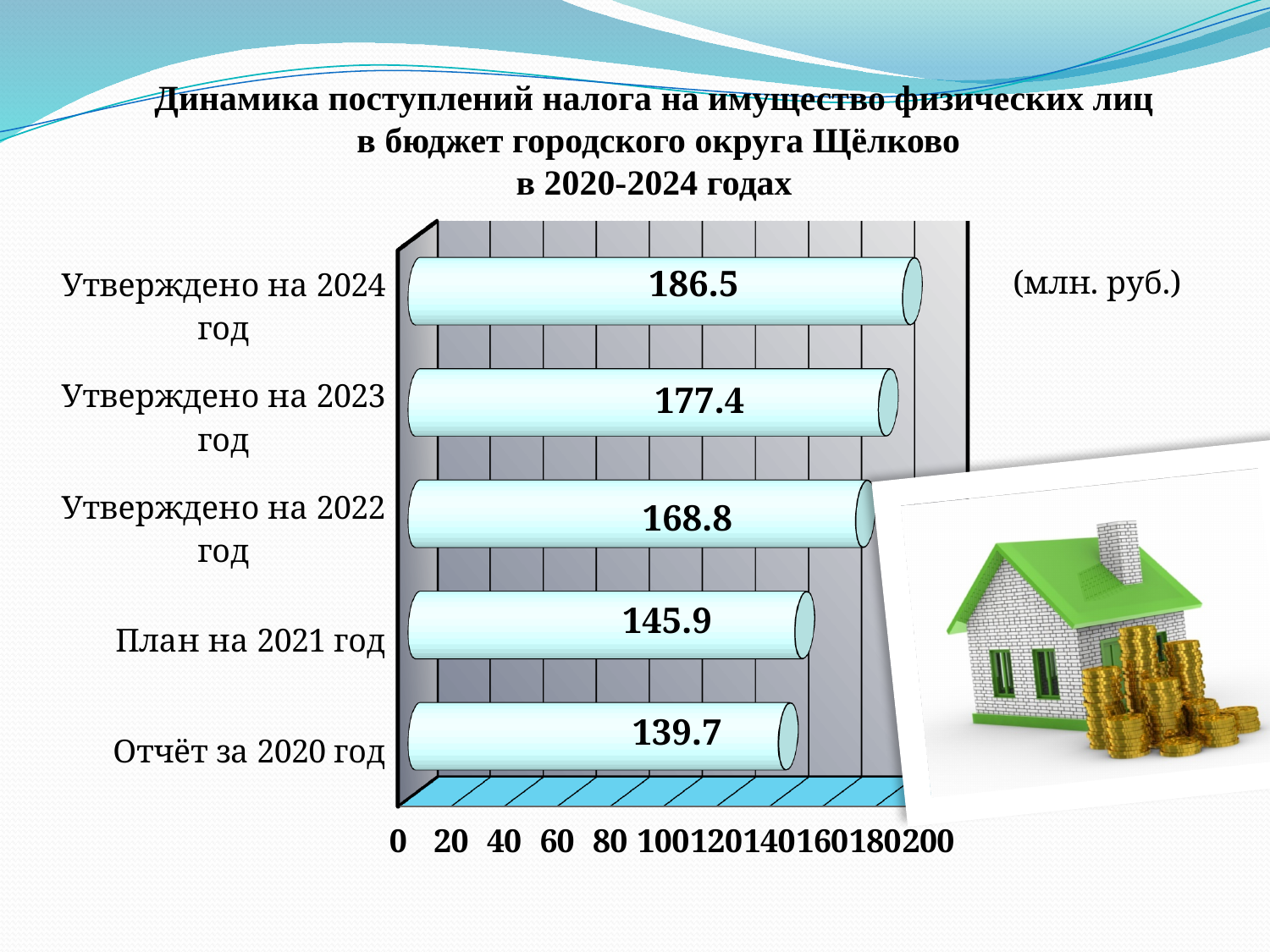
What is the difference between the values for "Утверждено на 2024 год" and "Утверждено на 2023 год"? 9.1 Do the values rise or fall from "Отчёт за 2020 год" to "Утверждено на 2024 год"? Rise What kind of chart is shown on the slide? Bar chart What is the difference between the values for "План на 2021 год" and "Отчёт за 2020 год"? 6.2 What value is shown for "Отчёт за 2020 год"? 139.7 What value is shown for "Утверждено на 2024 год"? 186.5 How many categories are shown in the chart? 5 Which category has the highest value? Утверждено на 2024 год What value is shown for "План на 2021 год"? 145.9 Which category has the lowest value? Отчёт за 2020 год What value is shown for "Утверждено на 2022 год"? 168.8 Which is larger: the value for "Утверждено на 2023 год" or "Утверждено на 2022 год"? Утверждено на 2023 год